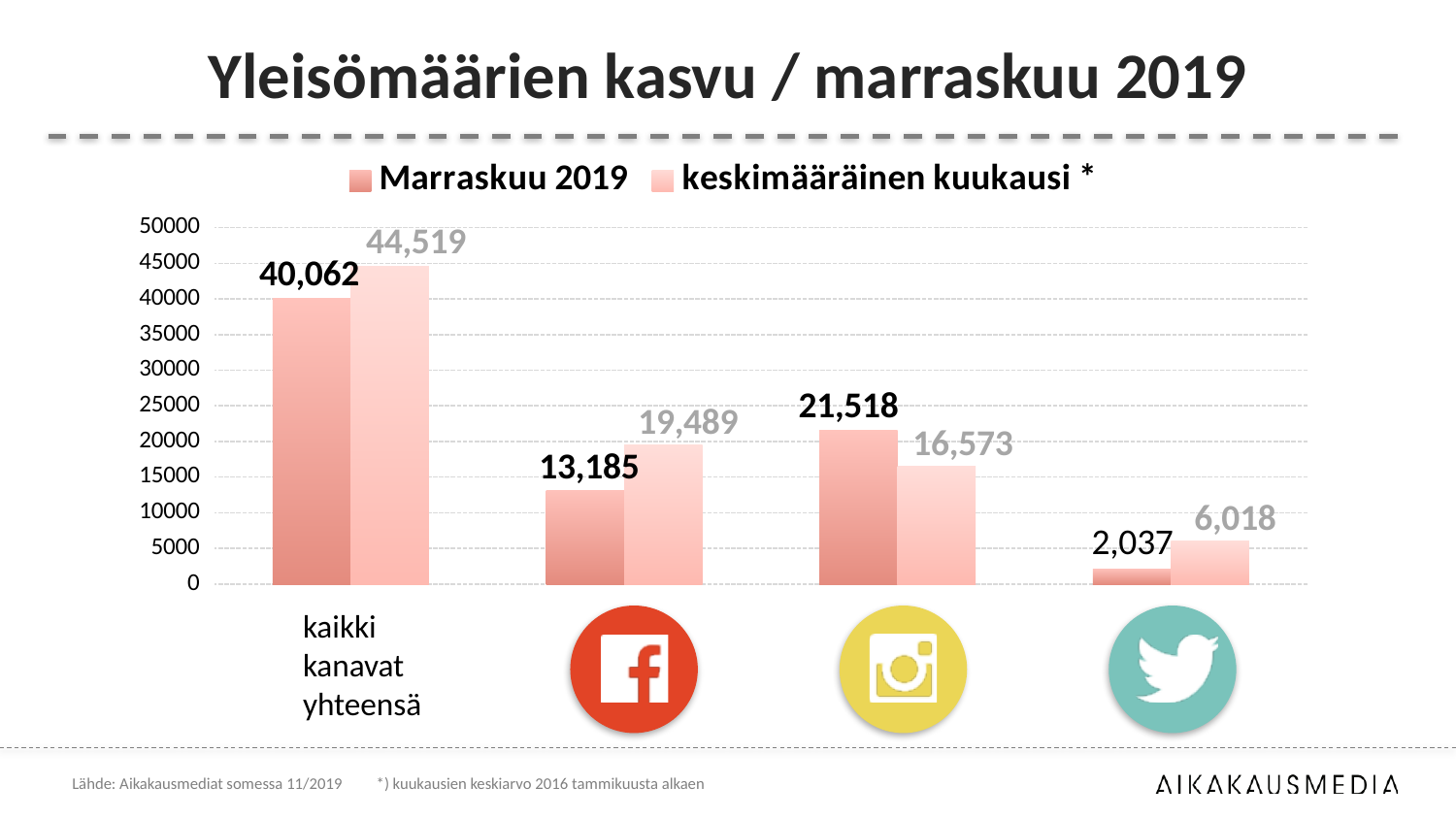
For the Instagram category, which is larger: Marraskuu 2019 or keskimääräinen kuukausi? Marraskuu 2019 How many series does the legend list? 2 Is the Marraskuu 2019 value for the Facebook category greater or less than 15000? less Which category has the lowest Marraskuu 2019 value? Twitter What is the Marraskuu 2019 value for kaikki kanavat yhteensä? 40,062 What is the keskimääräinen kuukausi value for the Facebook category? 19,489 What is the Marraskuu 2019 value for the Instagram category? 21,518 What is the difference between the keskimääräinen kuukausi and Marraskuu 2019 values for kaikki kanavat yhteensä? 4,457 How many categories are shown on the x axis? 4 What kind of chart is shown on the slide? bar chart What is the keskimääräinen kuukausi value for the Twitter category? 6,018 Which category has the highest keskimääräinen kuukausi value? kaikki kanavat yhteensä